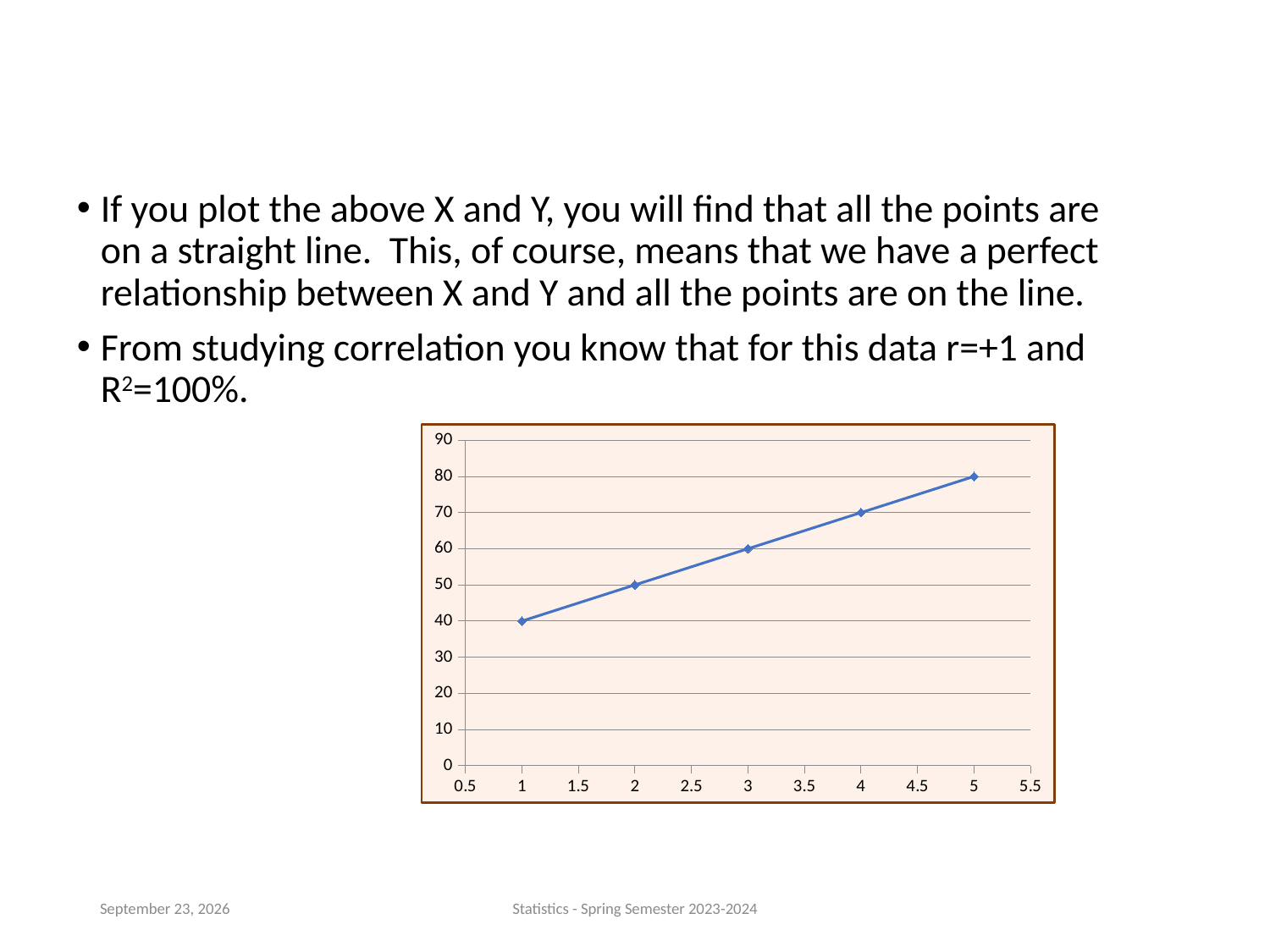
What is the highest value shown on the y axis? 90 At which x value is the plotted y value highest? 5 Which has the larger y value, the point at x = 2 or the point at x = 4? x = 4 How many data points are plotted on the chart? 5 Do the plotted values rise or fall as x increases? rise Is the y value at x = 4 greater or less than 60? greater What is the y value of the point at x = 5? 80 What kind of chart is shown on the slide? line chart What is the difference between the y values at x = 5 and x = 1? 40 What is the y value of the point at x = 1? 40 At which x value is the plotted y value lowest? 1 What is the y value of the point at x = 3? 60